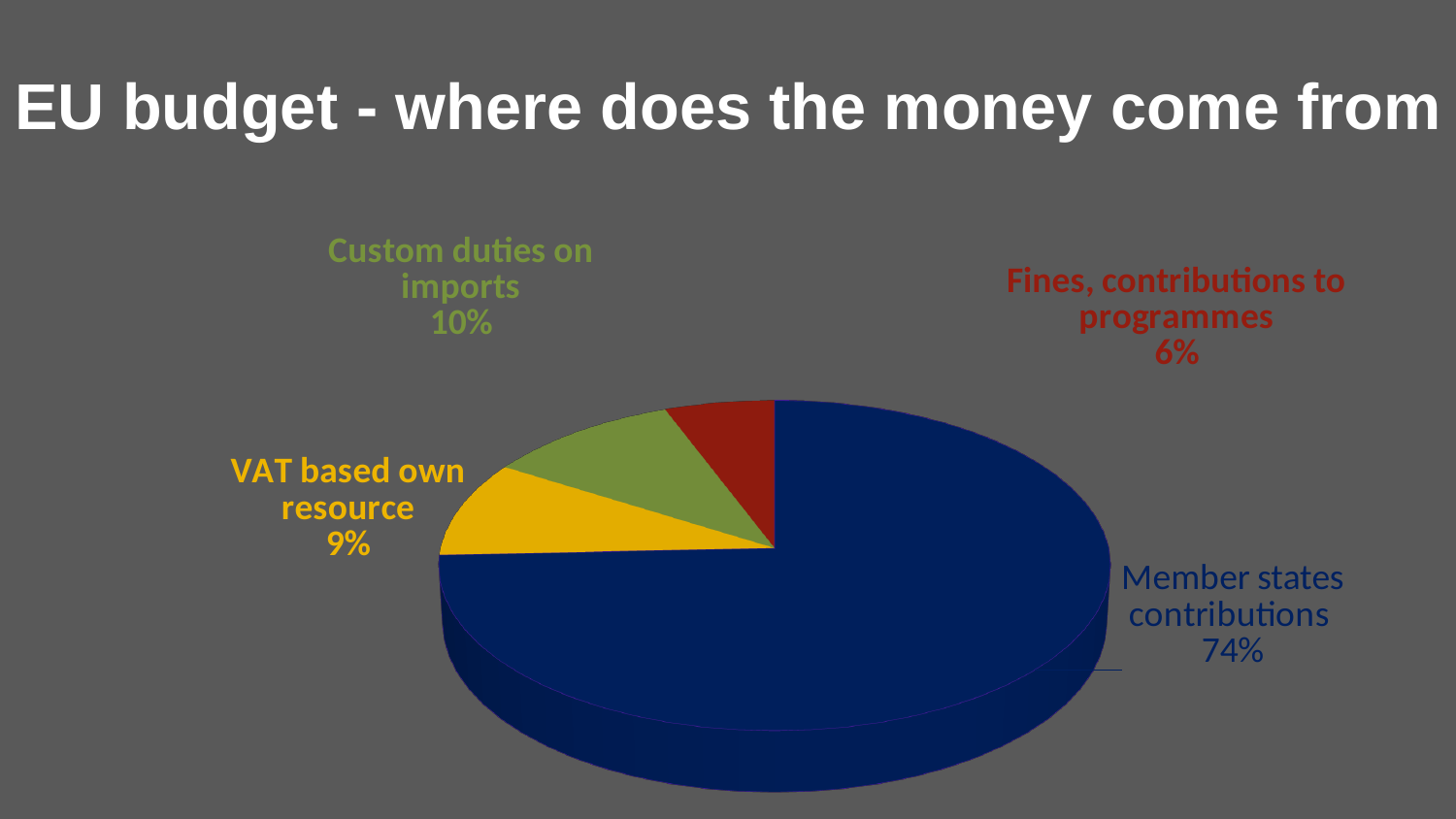
What is the difference in percentage points between Custom duties on imports and VAT based own resource? 1 Which source accounts for the smallest share of the EU budget? Fines, contributions to programmes How many sources of EU budget revenue are shown in the chart? 4 Which source accounts for the largest share of the EU budget? Member states contributions What percentage is shown for Fines, contributions to programmes? 6% Which is larger: the share for VAT based own resource or the share for Fines, contributions to programmes? VAT based own resource What kind of chart is shown on the slide? Pie chart What is the title of the slide? EU budget - where does the money come from What share of the EU budget comes from Member states contributions? 74% What percentage is shown for VAT based own resource? 9% What is the difference in percentage points between Member states contributions and Custom duties on imports? 64 What percentage of the EU budget comes from Custom duties on imports? 10%